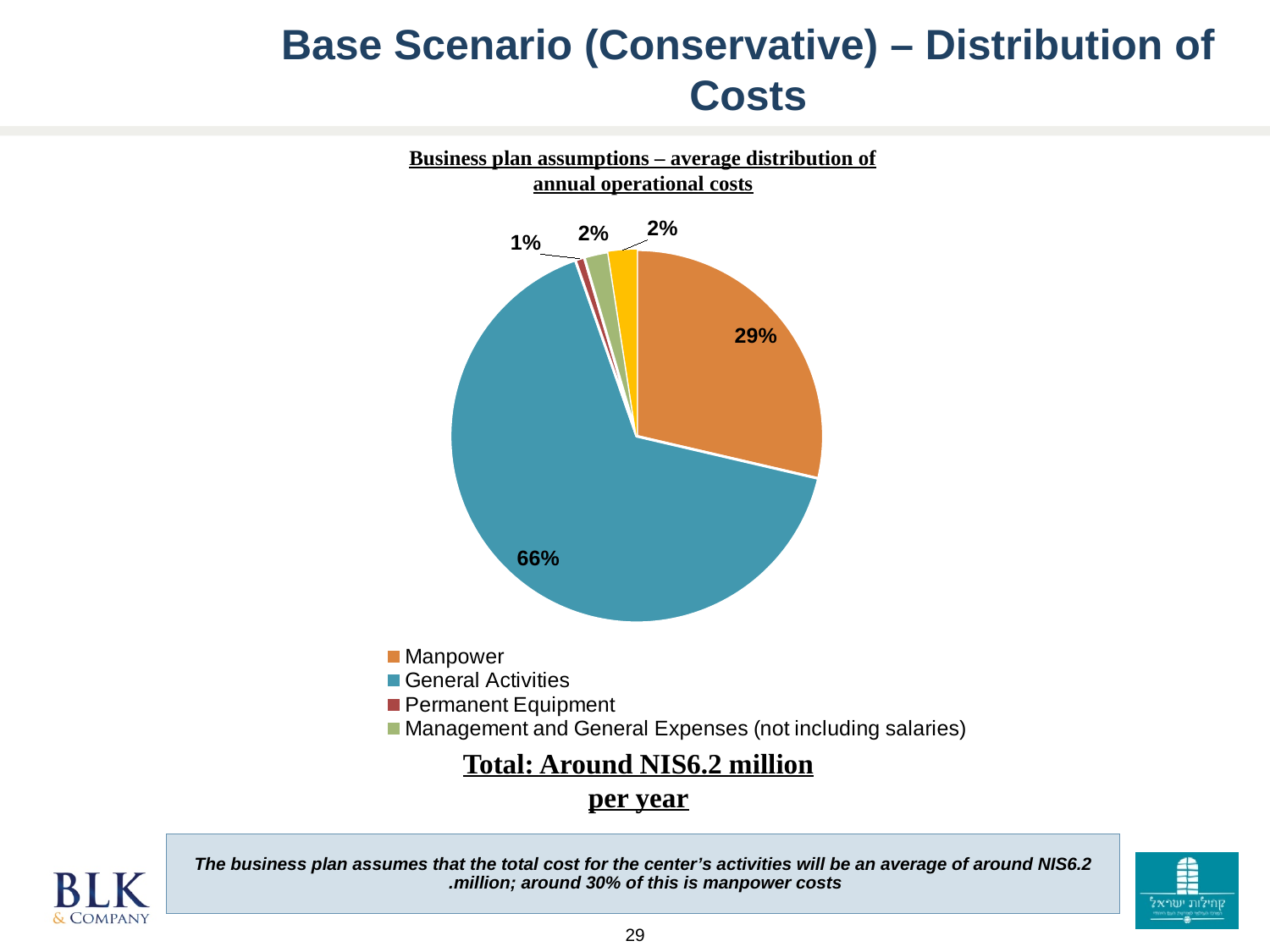
How many entries does the chart legend list? 4 Which category has the largest share of the pie? General Activities What share of annual operational costs is General Activities? 66% What kind of chart is shown on the slide? pie chart Which category has the smallest share of the pie? Permanent Equipment What share of annual operational costs is Management and General Expenses (not including salaries)? 2% How many slices does the pie chart have? 5 What share of annual operational costs is Permanent Equipment? 1% What colour is the Manpower slice in the pie chart? orange Which is larger, the Manpower share or the Permanent Equipment share? Manpower What share of annual operational costs is Manpower? 29% How many percentage points larger is the General Activities share than the Manpower share? 37%